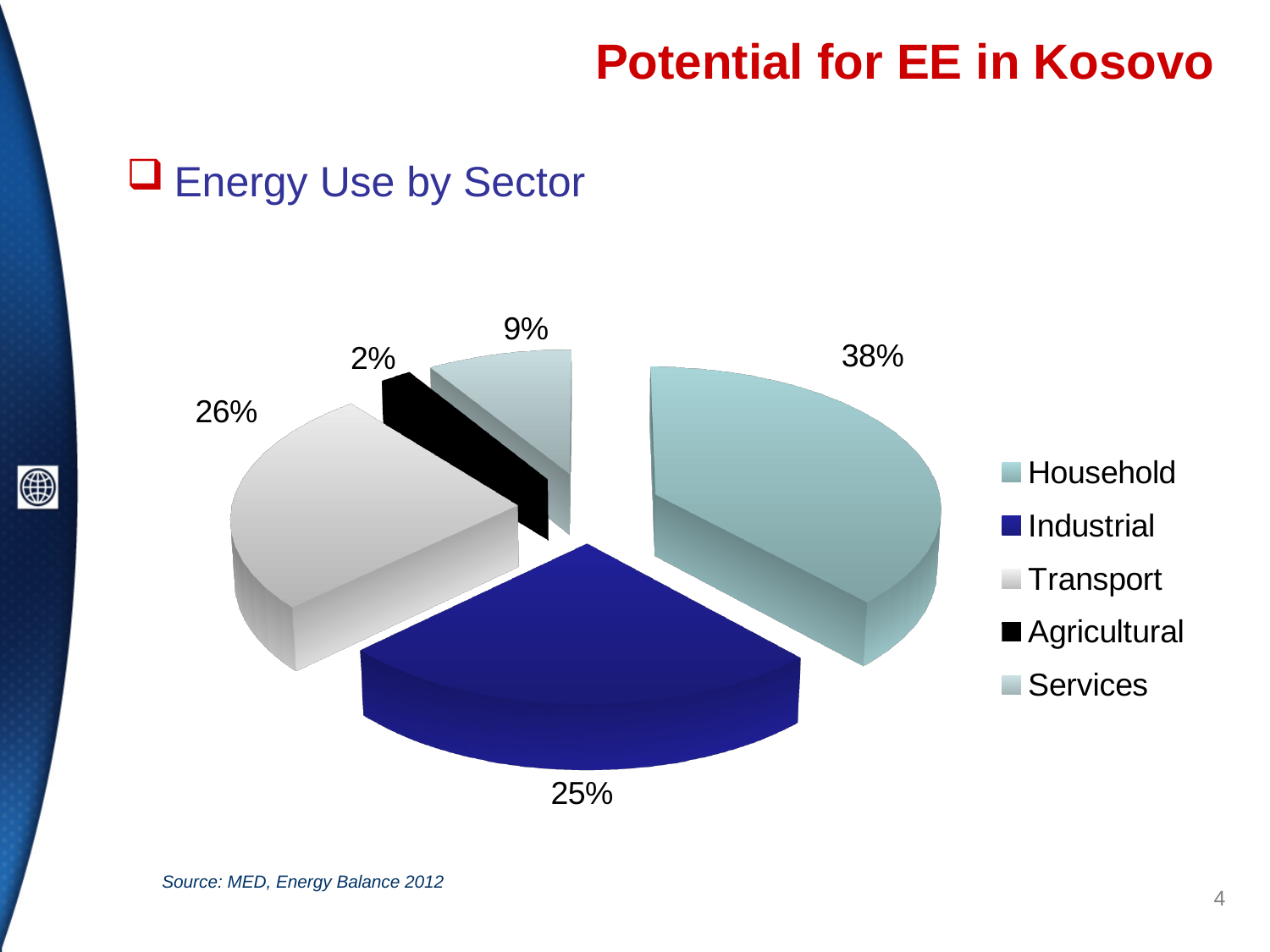
What share of energy use does the Services sector account for? 9% What share of energy use does the Industrial sector account for? 25% What type of chart is used to show energy use by sector? Pie chart What share of energy use does the Household sector account for? 38% What is the difference in percentage points between the Household and Industrial shares? 13 What share of energy use does the Transport sector account for? 26% Which sector has the largest share of energy use? Household Which sector has the smallest share of energy use? Agricultural What is the source cited for the chart data? MED, Energy Balance 2012 Which sector has a larger share of energy use, Transport or Services? Transport What share of energy use does the Agricultural sector account for? 2% How many sectors are shown in the pie chart? 5